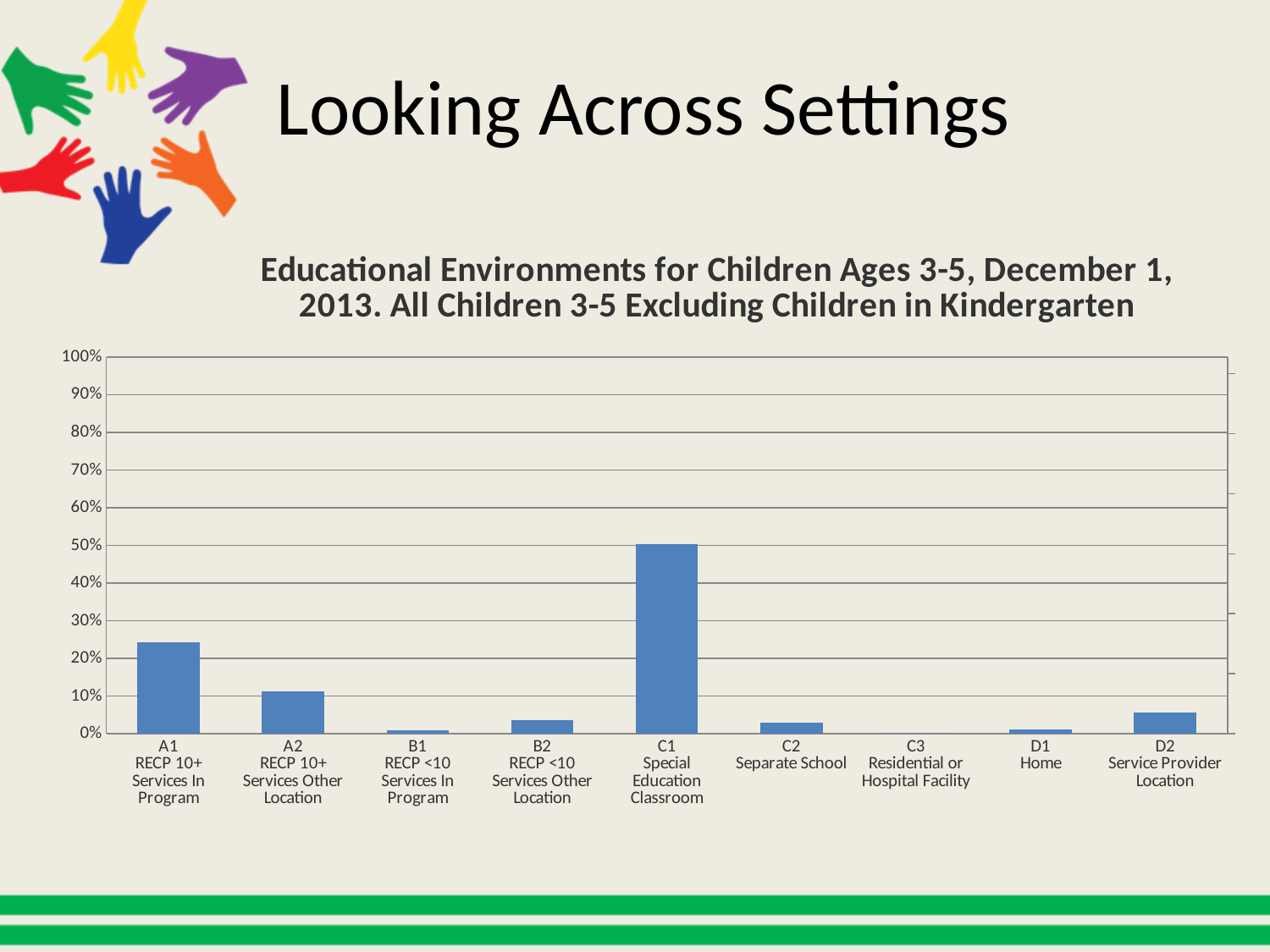
Which is larger, the value for D2 Service Provider Location or B2 RECP <10 Services Other Location? D2 Service Provider Location Is the value for D2 Service Provider Location greater or less than 10%? less Is the value for A1 RECP 10+ Services In Program greater or less than 20%? greater How many categories are shown on the x axis of the chart? 9 Is the value for C1 Special Education Classroom greater or less than 40%? greater Which category has the lowest value in the chart? C3 Residential or Hospital Facility What kind of chart is shown on the slide? bar chart Which category has the highest value in the chart? C1 Special Education Classroom Which is larger, the value for A1 RECP 10+ Services In Program or A2 RECP 10+ Services Other Location? A1 RECP 10+ Services In Program What is the title of the chart? Educational Environments for Children Ages 3-5, December 1, 2013. All Children 3-5 Excluding Children in Kindergarten